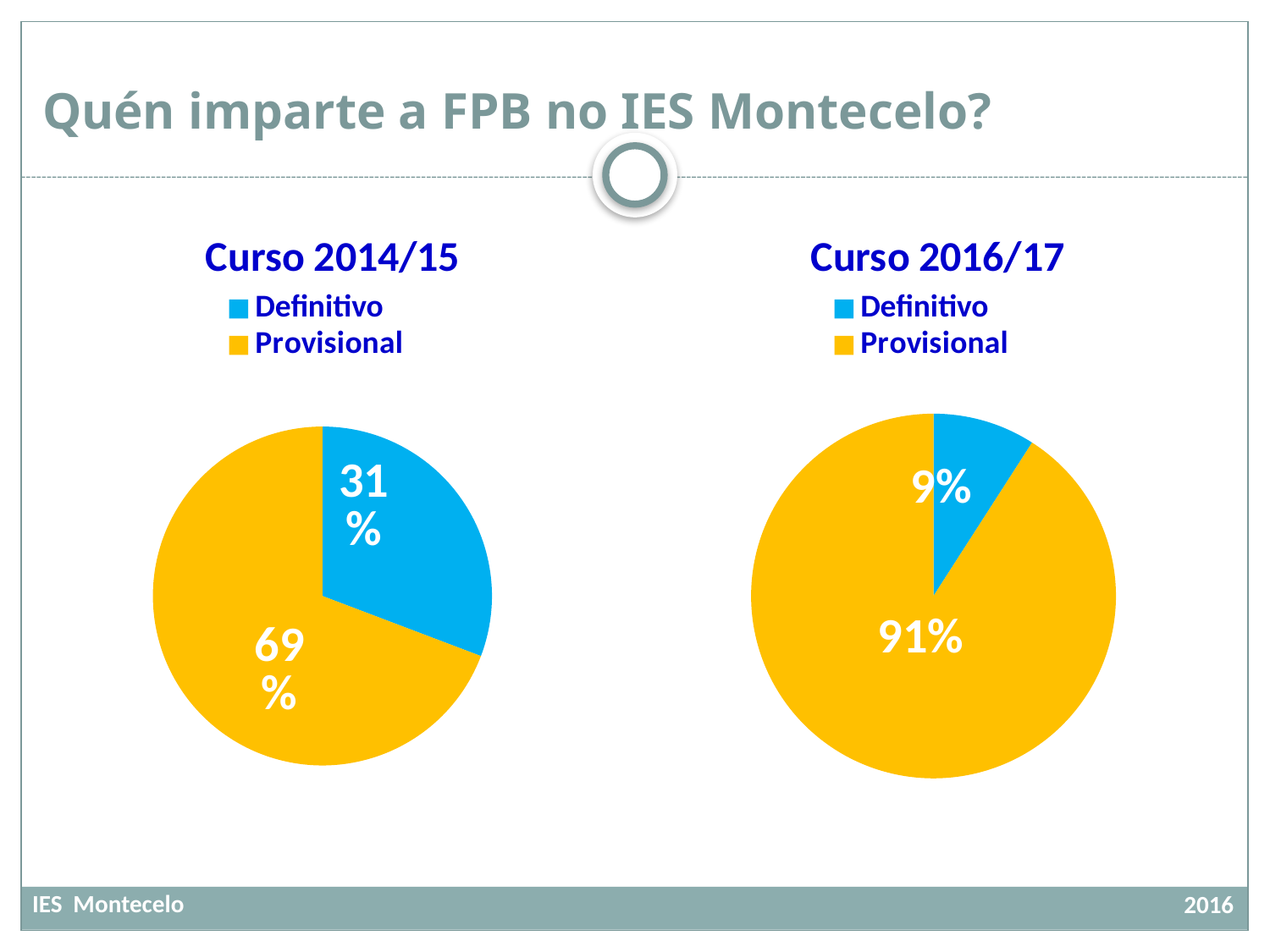
In the 'Curso 2014/15' chart, what is the difference in percentage points between Provisional and Definitivo? 38 In the 'Curso 2016/17' chart, what percentage is shown for Definitivo? 9% In the 'Curso 2014/15' chart, which category has the largest slice? Provisional In the 'Curso 2014/15' chart, what percentage is shown for Provisional? 69% In the 'Curso 2016/17' chart, which category has the smallest slice? Definitivo In the 'Curso 2016/17' chart, what is the difference in percentage points between Provisional and Definitivo? 82 In the 'Curso 2016/17' chart, what colour is the Provisional slice? Yellow In the 'Curso 2014/15' chart, what percentage is shown for Definitivo? 31% In the 'Curso 2016/17' chart, what percentage is shown for Provisional? 91% Which chart shows a larger Definitivo share, 'Curso 2014/15' or 'Curso 2016/17'? Curso 2014/15 What type of chart is the 'Curso 2016/17' chart? Pie chart How many categories does the legend of the 'Curso 2014/15' chart list? 2